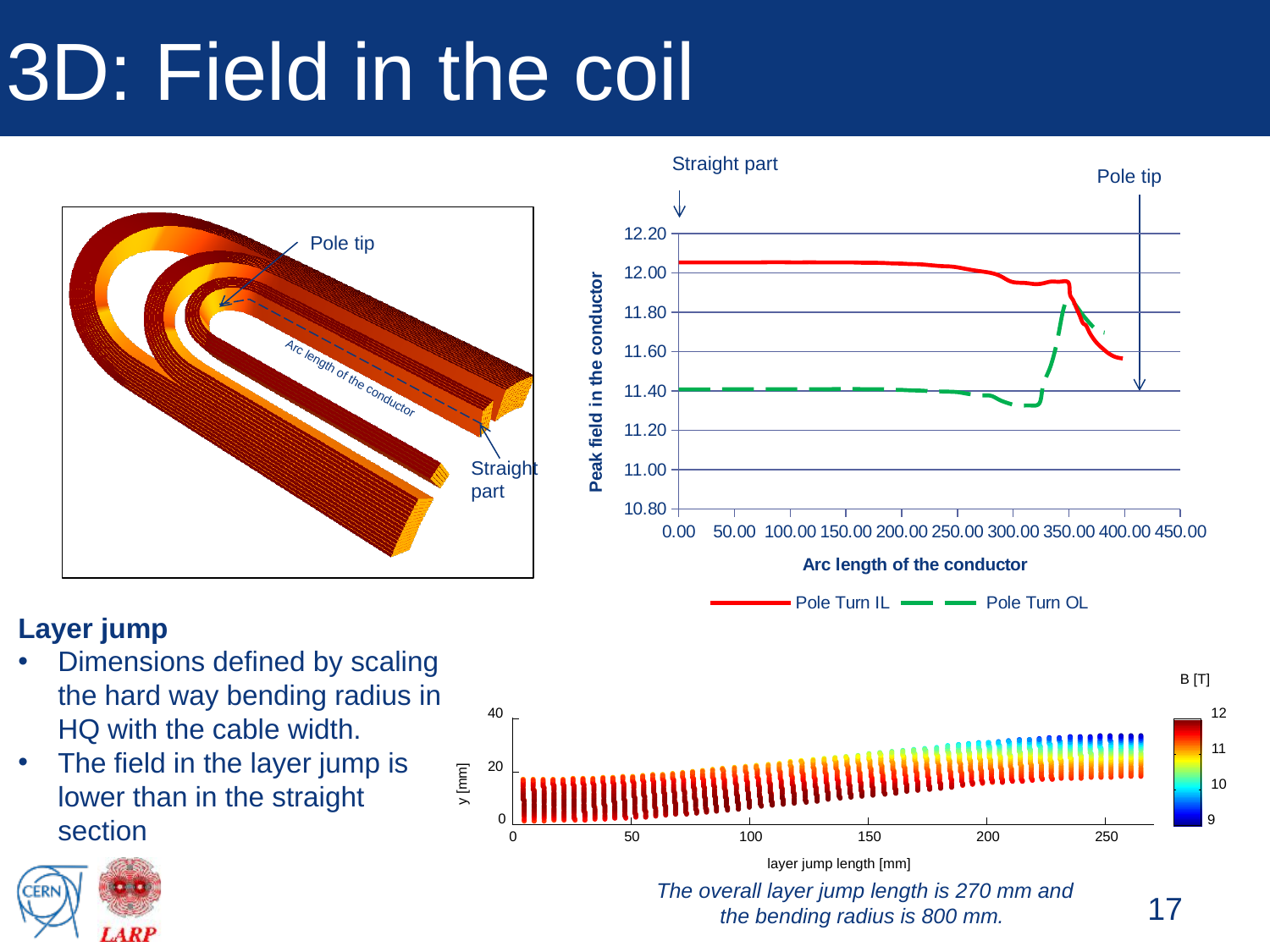
In the 'Peak field in the conductor' chart, is the value of Pole Turn IL at arc length 0.00 greater or less than 11.80? greater In the 'Peak field in the conductor' chart, is the value of Pole Turn OL at arc length 0.00 greater or less than 11.60? less In the 'Peak field in the conductor' chart, what are the two series named in the legend? Pole Turn IL and Pole Turn OL In the 'Peak field in the conductor' chart, which series reaches the highest value anywhere on the chart? Pole Turn IL In the 'Peak field in the conductor' chart, which series has the higher value at arc length 100.00, Pole Turn IL or Pole Turn OL? Pole Turn IL How many series does the legend of the 'Peak field in the conductor' chart list? 2 In the 'Peak field in the conductor' chart, which series is drawn as a green dashed line? Pole Turn OL In the 'Peak field in the conductor' chart, which series reaches the lowest value anywhere on the chart? Pole Turn OL In the 'Peak field in the conductor' chart, does the Pole Turn IL line rise or fall between arc length 300.00 and 400.00? fall What kind of chart is the 'Peak field in the conductor' chart? line chart In the 'Peak field in the conductor' chart, is the value of Pole Turn OL at arc length 100.00 greater or less than 11.20? greater